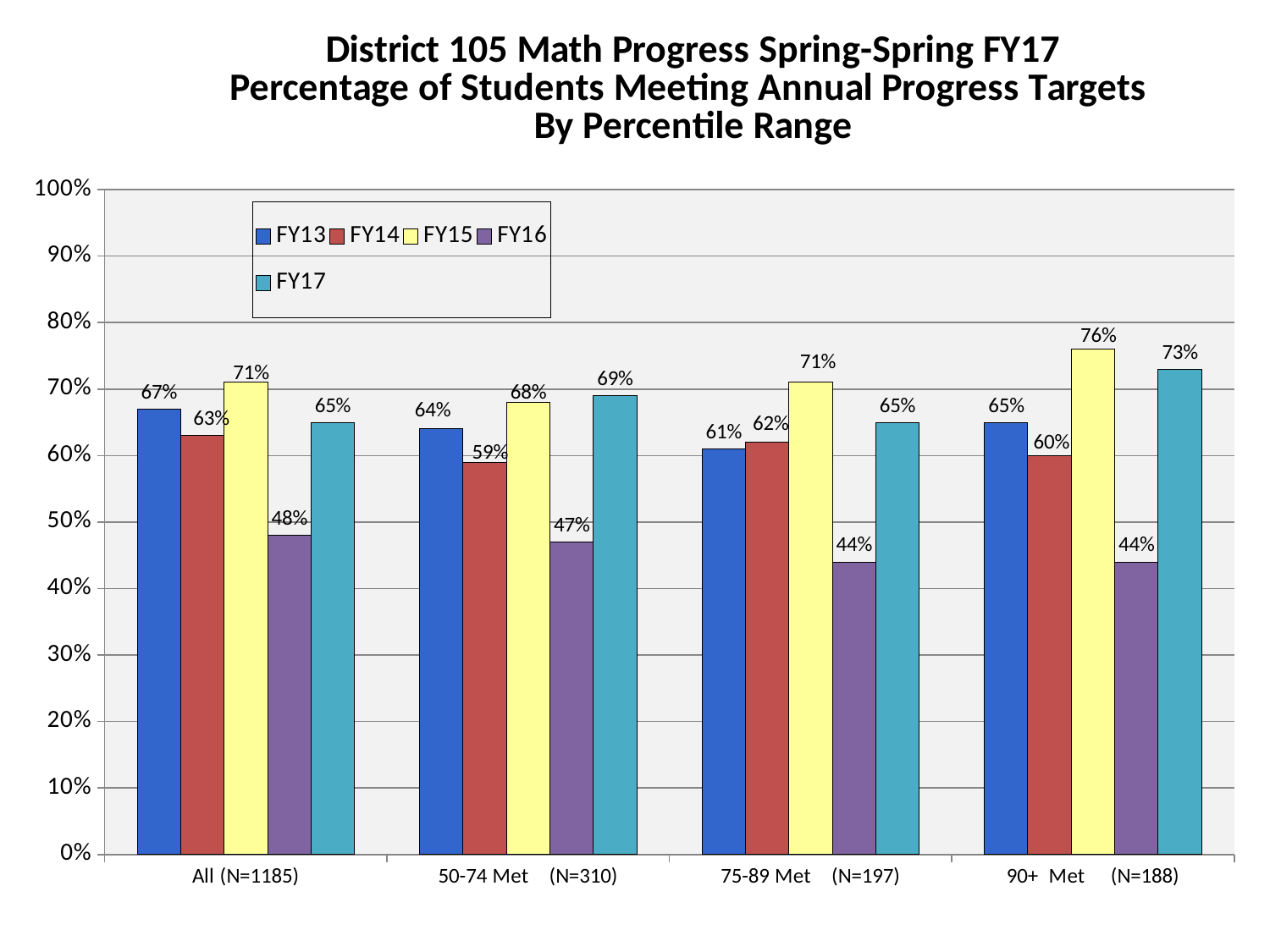
What is the FY17 value for the 90+ Met (N=188) category? 73% Which is larger for the 50-74 Met (N=310) category, the FY13 value or the FY17 value? FY17 Do the FY16 values rise or fall from the All (N=1185) category to the 75-89 Met (N=197) category? Fall What is the FY16 value for the All (N=1185) category? 48% What is the title of the chart? District 105 Math Progress Spring-Spring FY17 Percentage of Students Meeting Annual Progress Targets By Percentile Range What kind of chart is shown on the slide? Bar chart How many categories are shown on the x axis? 4 Which category has the highest FY15 value? 90+ Met (N=188) What is the FY14 value for the 50-74 Met (N=310) category? 59% What is the difference between the FY15 and FY16 values for the 75-89 Met (N=197) category? 27% How many series does the legend list? 5 Which category has the lowest FY13 value? 75-89 Met (N=197)